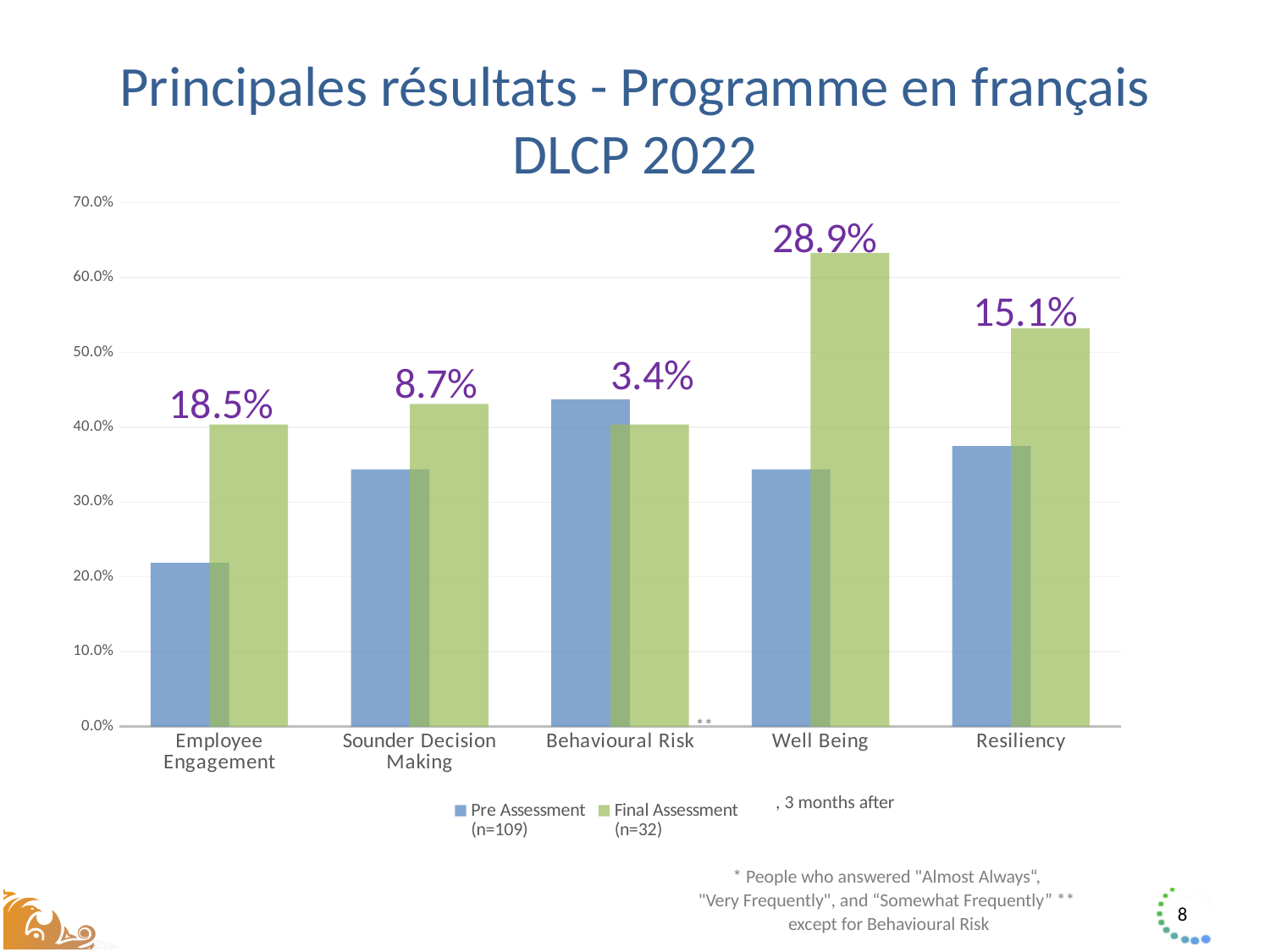
Which category has the highest Final Assessment (n=32) bar? Well Being What percentage label is printed above the Well Being bars? 28.9% Is the Pre Assessment (n=109) value for Employee Engagement greater or less than 30.0%? less Is the Final Assessment (n=32) value for Well Being greater or less than 60.0%? greater For Well Being, which is larger: the Pre Assessment (n=109) bar or the Final Assessment (n=32) bar? Final Assessment (n=32) How many series does the chart's legend list? 2 Which category has the highest Pre Assessment (n=109) bar? Behavioural Risk How many categories are shown on the x axis of the chart? 5 Which category has the lowest Pre Assessment (n=109) bar? Employee Engagement For Behavioural Risk, which is larger: the Pre Assessment (n=109) bar or the Final Assessment (n=32) bar? Pre Assessment (n=109) What kind of chart is shown on the slide? bar chart Is the Final Assessment (n=32) value for Resiliency greater or less than 50.0%? greater